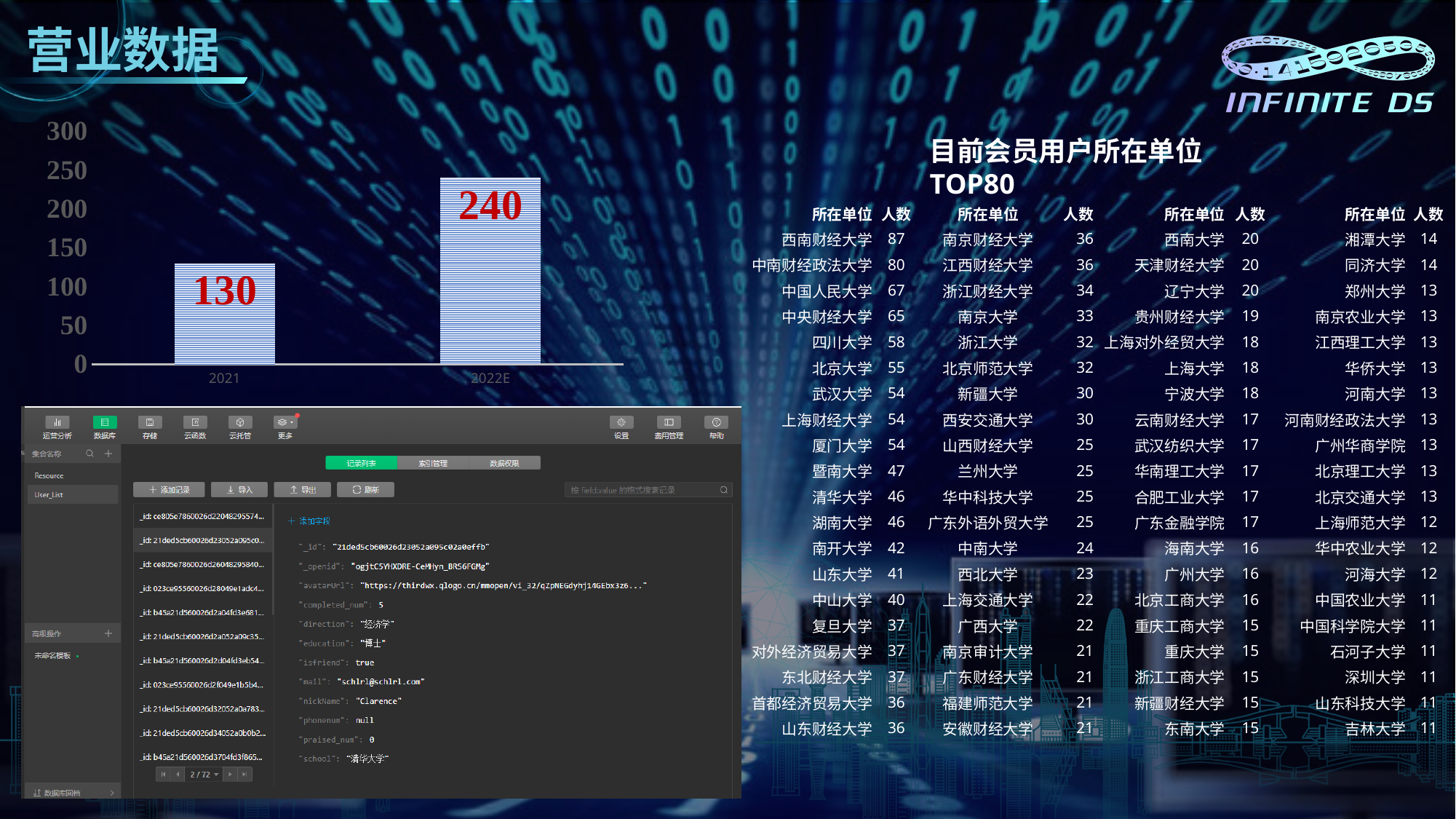
Which category has the highest value in the bar chart? 2022E Is the value for 2022E greater or less than 200? greater What kind of chart is shown on the left of the slide? bar chart How many categories are shown on the x axis of the bar chart? 2 What is the highest tick value shown on the y axis of the bar chart? 300 Do the values in the bar chart rise or fall from 2021 to 2022E? rise Is the value for 2021 greater or less than 150? less Which category has the lowest value in the bar chart? 2021 What is the value for 2022E in the bar chart? 240 What is the value for 2021 in the bar chart? 130 What is the difference between the values for 2022E and 2021 in the bar chart? 110 Which is larger in the bar chart, the value for 2021 or the value for 2022E? 2022E